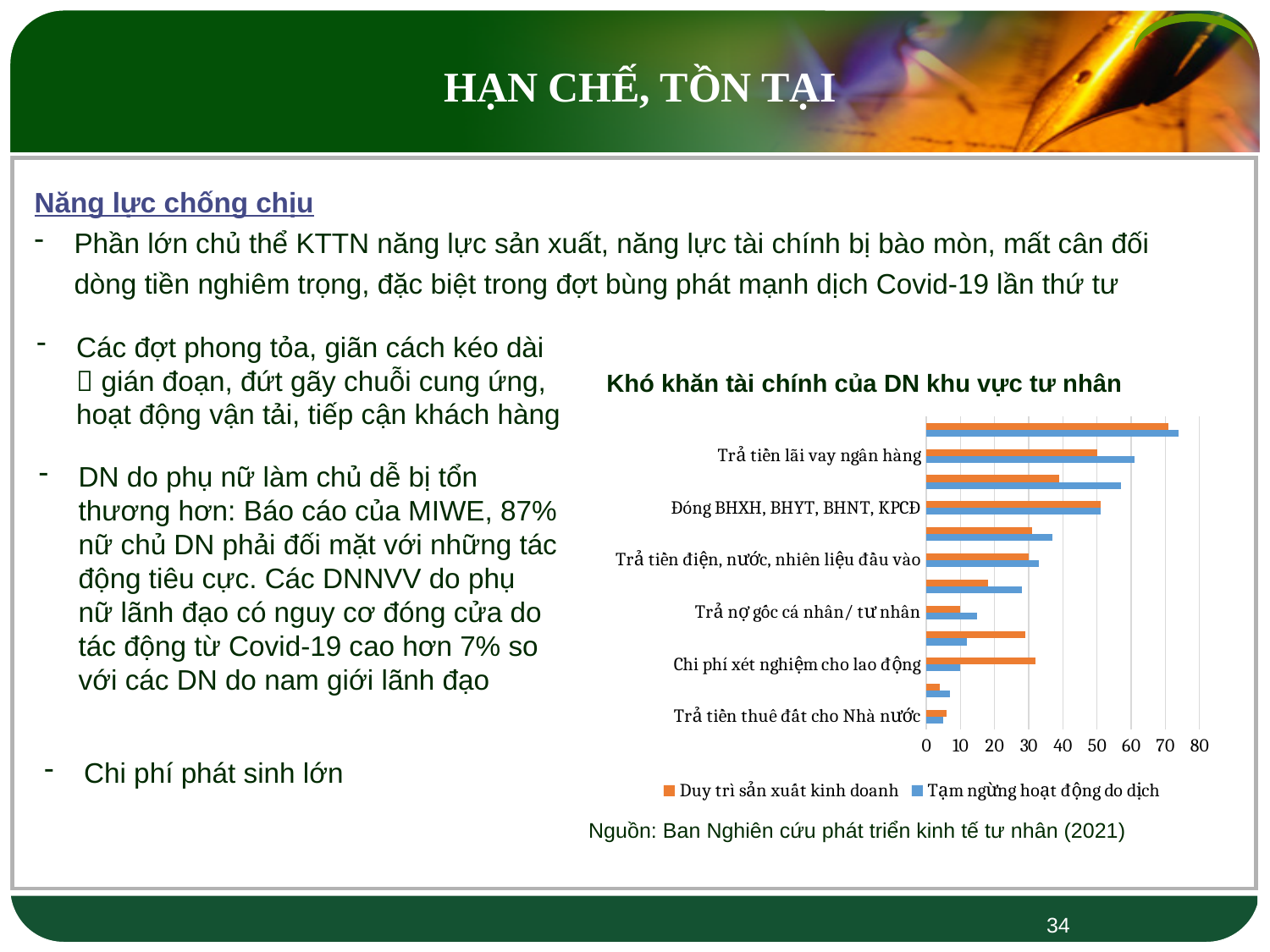
Is the value of 'Duy trì sản xuất kinh doanh' for 'Chi phí xét nghiệm cho lao động' greater or less than 20? greater Is the value of 'Tạm ngừng hoạt động do dịch' for 'Trả tiền lãi vay ngân hàng' greater or less than 50? greater Is the value of 'Duy trì sản xuất kinh doanh' for 'Trả tiền điện, nước, nhiên liệu đầu vào' greater or less than 40? less How many series does the chart legend list? 2 What kind of chart is shown on the slide? bar chart Which series is shown in orange in the chart? Duy trì sản xuất kinh doanh For 'Trả tiền lãi vay ngân hàng', which series has the larger value: 'Duy trì sản xuất kinh doanh' or 'Tạm ngừng hoạt động do dịch'? Tạm ngừng hoạt động do dịch What is the title of the chart? Khó khăn tài chính của DN khu vực tư nhân For 'Chi phí xét nghiệm cho lao động', which series has the larger value: 'Duy trì sản xuất kinh doanh' or 'Tạm ngừng hoạt động do dịch'? Duy trì sản xuất kinh doanh